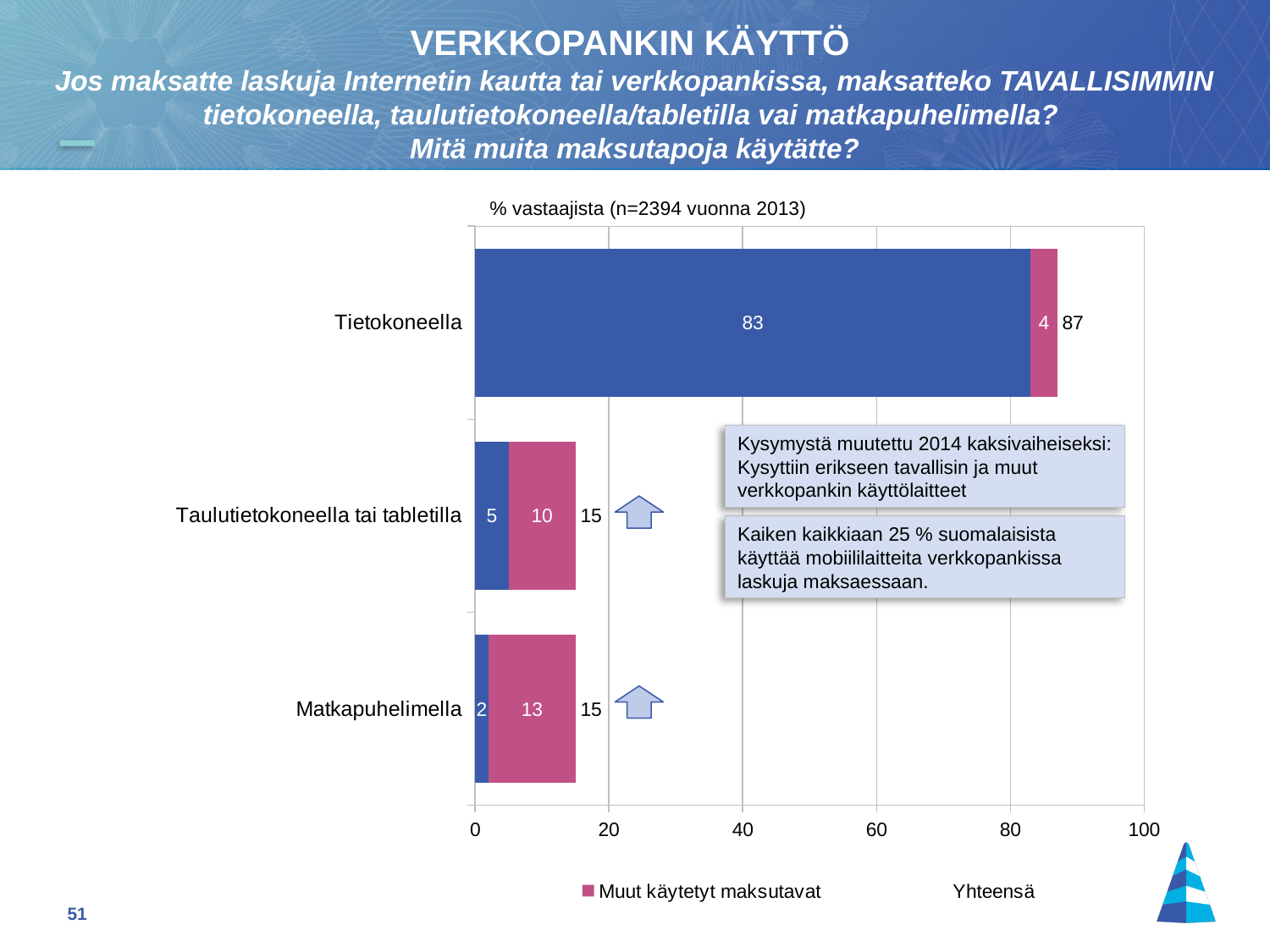
How many categories are shown on the chart? 3 What is the value of Muut käytetyt maksutavat for Matkapuhelimella? 13 Which has the larger Muut käytetyt maksutavat value, Matkapuhelimella or Taulutietokoneella tai tabletilla? Matkapuhelimella What kind of chart is shown on the slide? Bar chart Which category has the highest total? Tietokoneella What is the value of Muut käytetyt maksutavat for Taulutietokoneella tai tabletilla? 10 What is the value of the blue segment for Tietokoneella? 83 What is the total shown for the Tietokoneella bar? 87 What is the total shown for the Matkapuhelimella bar? 15 What is the axis title shown above the chart? % vastaajista (n=2394 vuonna 2013) What is the difference between the total for Tietokoneella and the total for Taulutietokoneella tai tabletilla? 72 What is the value of Muut käytetyt maksutavat for Tietokoneella? 4